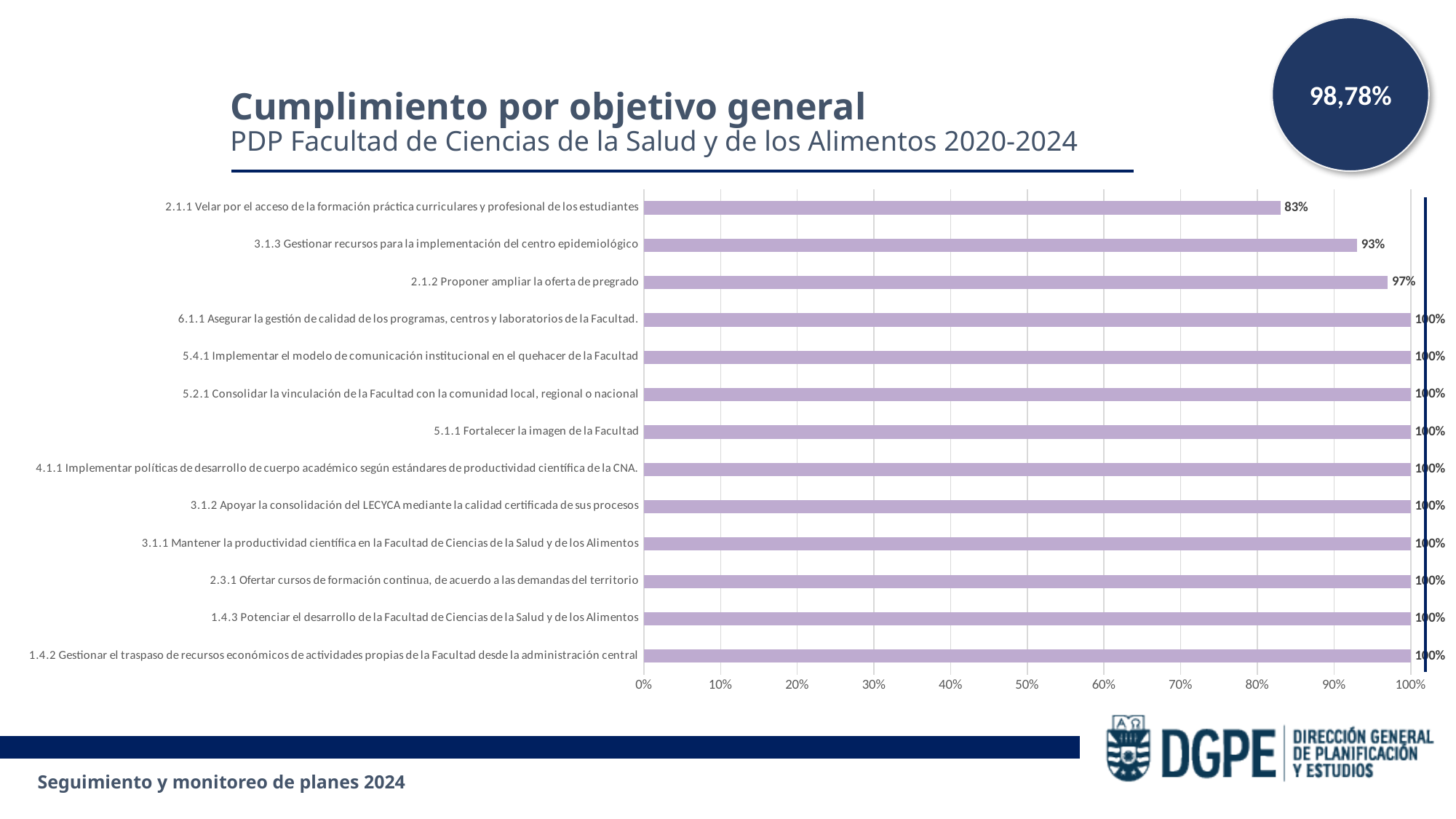
What is the value for 2.1.2 Proponer ampliar la oferta de pregrado? 97% Is the value for 2.1.1 Velar por el acceso de la formación práctica curriculares y profesional de los estudiantes greater or less than 90%? less What kind of chart is shown on the slide? bar chart What is the value for 5.1.1 Fortalecer la imagen de la Facultad? 100% What is the difference between the values for 3.1.3 Gestionar recursos para la implementación del centro epidemiológico and 2.1.1 Velar por el acceso de la formación práctica curriculares y profesional de los estudiantes? 10% What is the value for 2.1.1 Velar por el acceso de la formación práctica curriculares y profesional de los estudiantes? 83% Which is larger, the value for 3.1.3 Gestionar recursos para la implementación del centro epidemiológico or the value for 2.1.2 Proponer ampliar la oferta de pregrado? 2.1.2 Proponer ampliar la oferta de pregrado What is the title of the chart? Cumplimiento por objetivo general How many objectives are plotted in the chart? 13 What is the difference between the values for 2.1.2 Proponer ampliar la oferta de pregrado and 2.1.1 Velar por el acceso de la formación práctica curriculares y profesional de los estudiantes? 14% Which objective has the lowest value? 2.1.1 Velar por el acceso de la formación práctica curriculares y profesional de los estudiantes What is the value for 3.1.3 Gestionar recursos para la implementación del centro epidemiológico? 93%